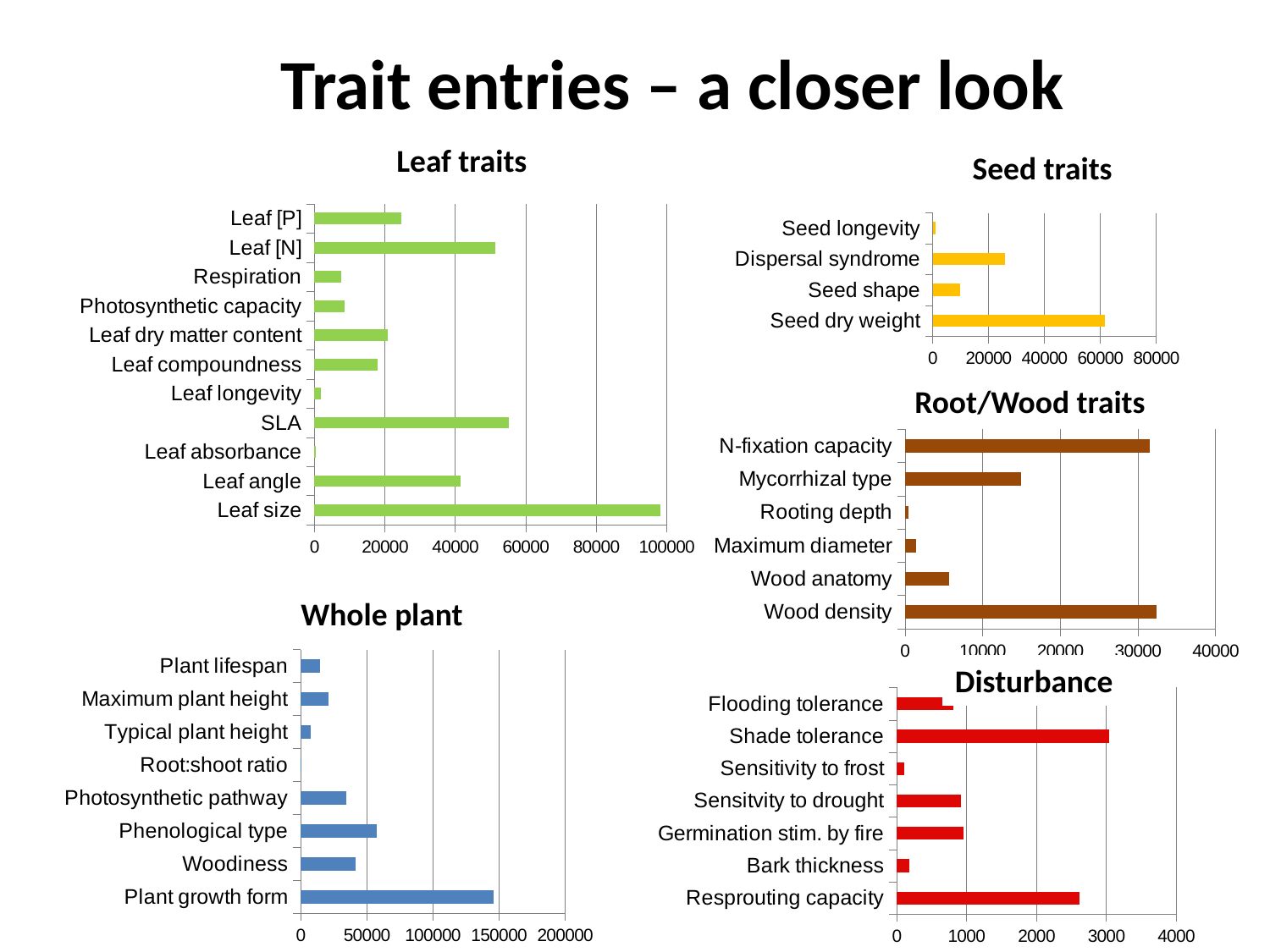
In the Leaf traits chart, which is larger, Leaf angle or Leaf [P]? Leaf angle In the Whole plant chart, is the value for Plant growth form greater or less than 100000? greater How many categories are shown in the Leaf traits chart? 11 In the Seed traits chart, which category has the highest value? Seed dry weight In the Disturbance chart, which category has the highest value? Shade tolerance How many categories are shown in the Whole plant chart? 8 In the Root/Wood traits chart, which category has the lowest value? Rooting depth In the Leaf traits chart, is the value for Leaf size greater or less than 80000? greater What kind of chart is the Disturbance chart? Bar chart In the Root/Wood traits chart, is the value for Mycorrhizal type greater or less than 10000? greater In the Leaf traits chart, which category has the highest value? Leaf size In the Seed traits chart, which category has the lowest value? Seed longevity